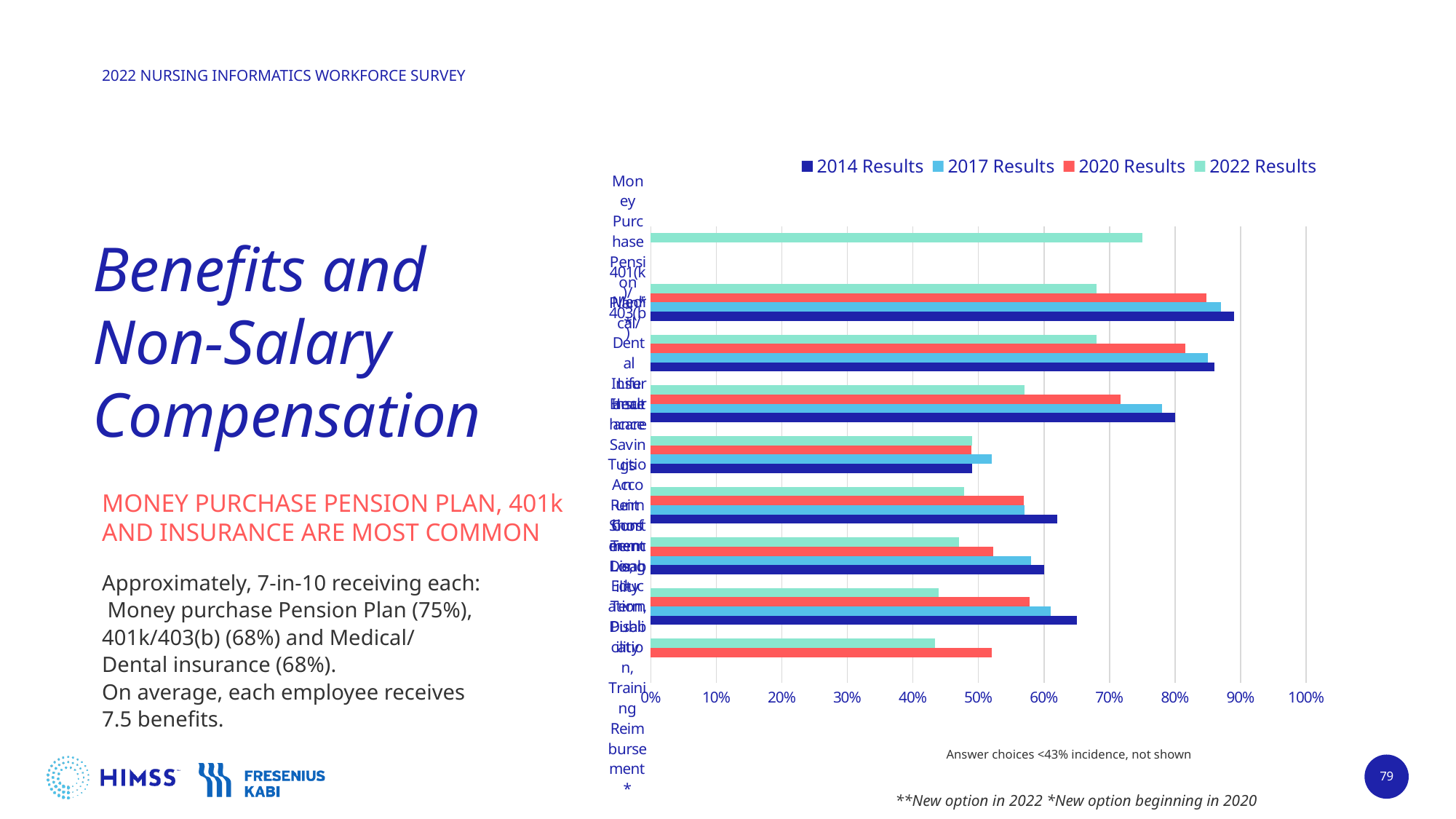
Is the 2022 Results value for the bottom category on the chart greater or less than 50%? less For 401(k)/403(b), which is larger: the 2014 Results value or the 2022 Results value? 2014 Results Is the 2022 Results value for 401(k)/403(b) greater or less than 70%? less Is the 2014 Results value for 401(k)/403(b) greater or less than 80%? greater For 401(k)/403(b), do the values rise or fall from 2014 Results to 2022 Results? Fall Which series has the longest bar anywhere on the chart? 2014 Results How many benefit categories are plotted on the chart? 9 How many series does the chart legend list? 4 What kind of chart is shown on the slide? Bar chart Which series are listed in the chart legend? 2014 Results, 2017 Results, 2020 Results, 2022 Results Which series is the only one plotted for the Money Purchase Pension Plan category? 2022 Results